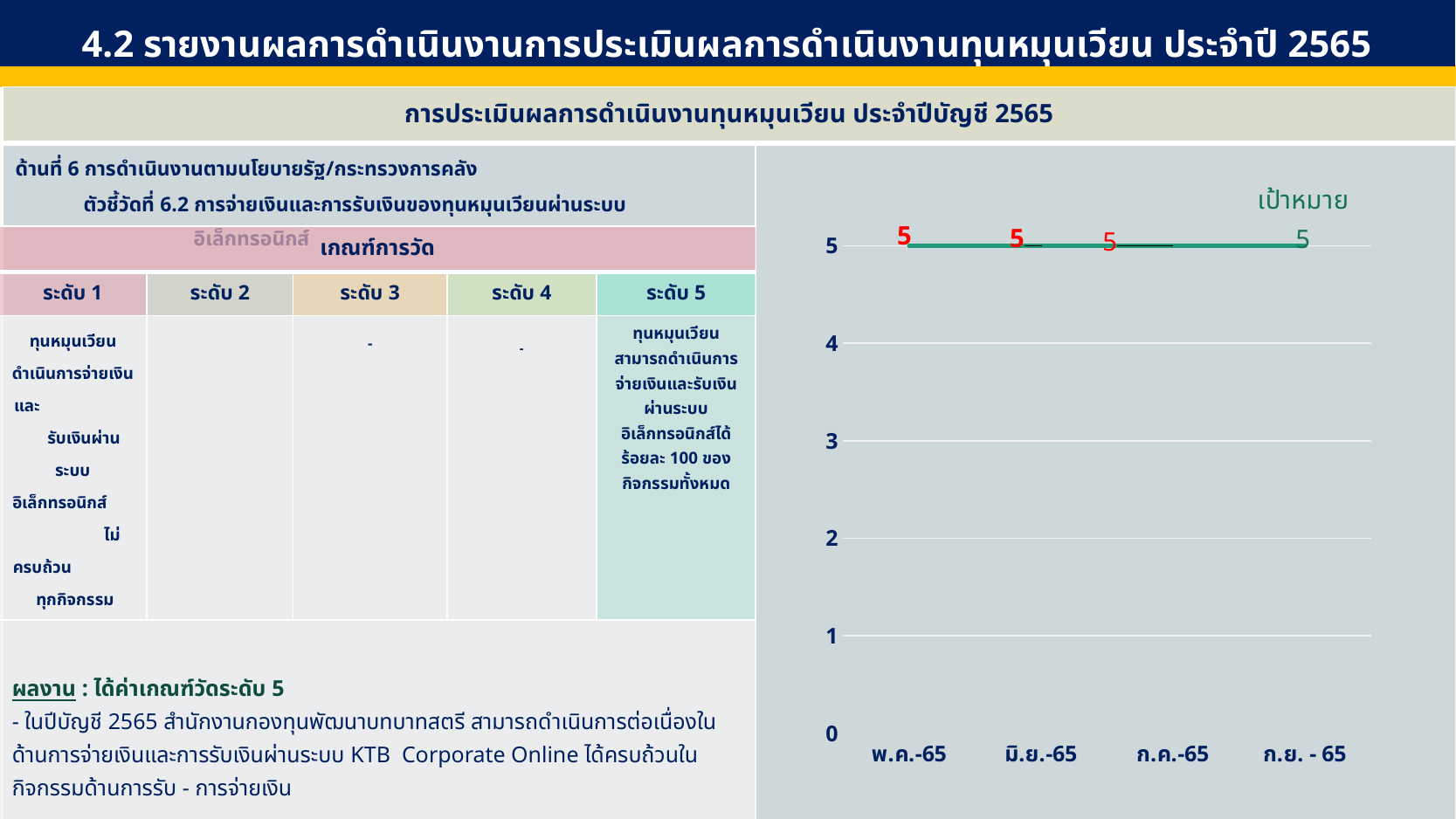
What is the value plotted for ก.ย. - 65? 5 What is the highest value shown on the y axis of the chart? 5 What kind of chart is shown on the right side of the slide? line chart What is the value plotted for พ.ค.-65? 5 How many points are plotted along the x axis of the chart? 4 What is the difference between the values for พ.ค.-65 and ก.ย. - 65? 0 Do the plotted values rise, fall, or stay flat from พ.ค.-65 to ก.ย. - 65? stay flat Is the value for ก.ค.-65 greater or less than 4? greater What is the value plotted for มิ.ย.-65? 5 What label is shown in green above the line in the chart? เป้าหมาย What is the first category on the x axis of the chart? พ.ค.-65 What is the value plotted for ก.ค.-65? 5